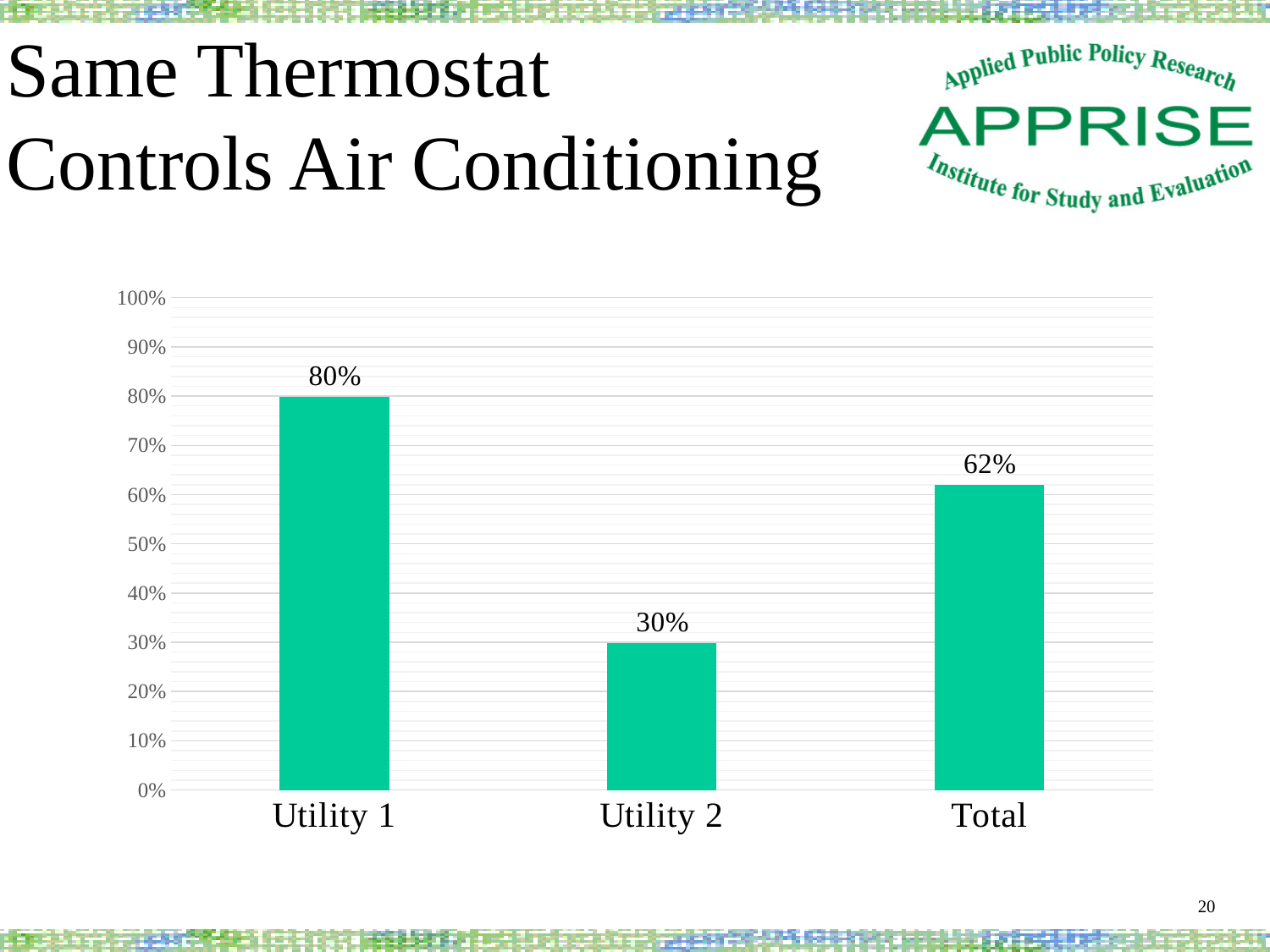
What is the title of the slide containing the chart? Same Thermostat Controls Air Conditioning Which is larger, the value for Utility 2 or the value for Total? Total What is the difference between the values for Utility 1 and Total? 18% Which category has the highest value? Utility 1 Is the value for Total greater or less than 50%? greater What kind of chart is shown on the slide? bar chart Which category has the lowest value? Utility 2 What is the value for Total? 62% What is the value for Utility 1? 80% What is the difference between the values for Utility 1 and Utility 2? 50% How many categories are shown on the x axis? 3 What is the value for Utility 2? 30%